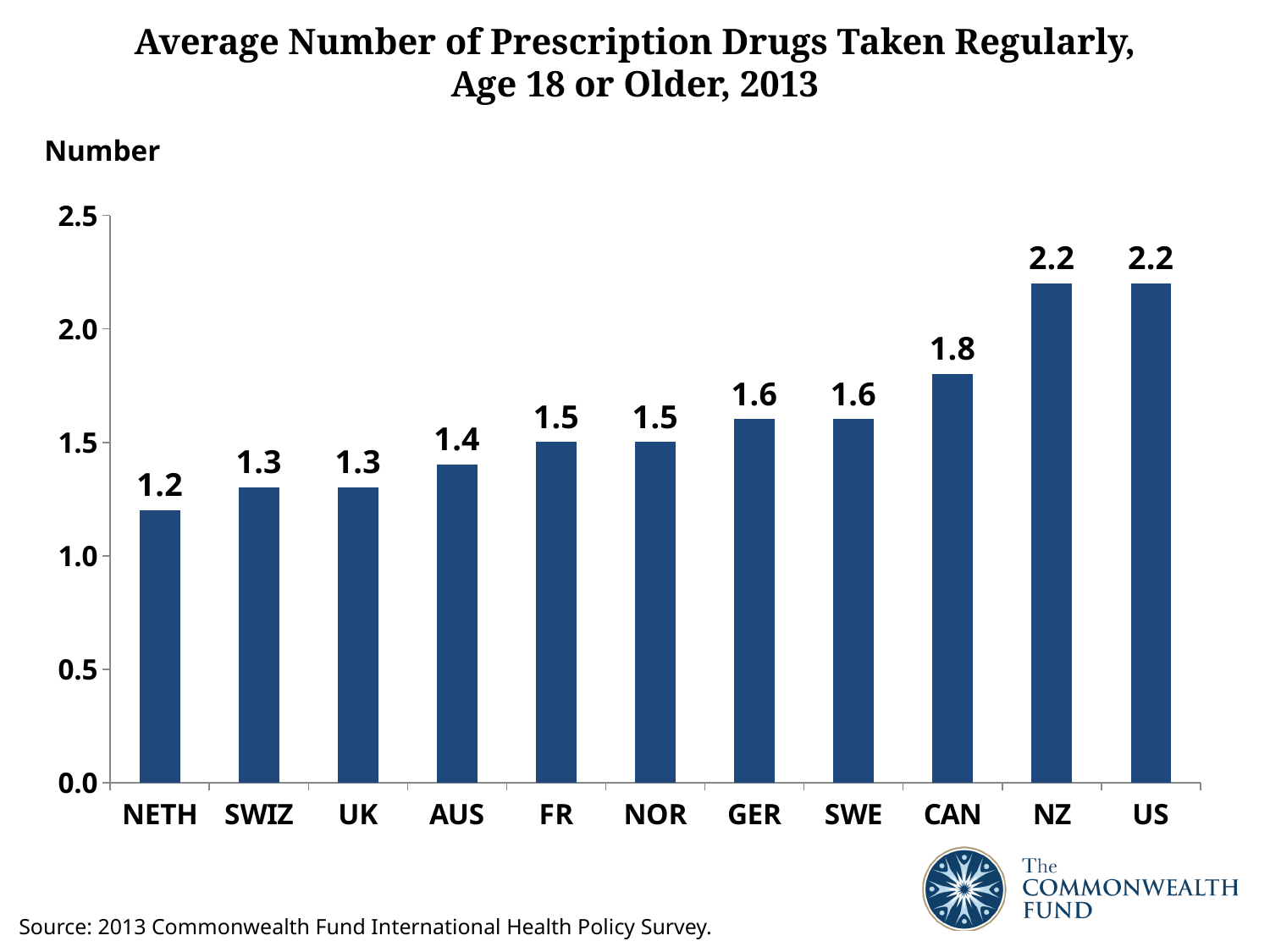
Which is larger, the value for CAN or the value for SWE? CAN What is the value shown for AUS? 1.4 How many countries are shown on the chart? 11 Do the values generally rise or fall from left to right across the x axis? Rise What is the value shown for CAN? 1.8 What is the difference between the values for US and NETH? 1.0 What kind of chart is shown on the slide? Bar chart Is the value for NZ greater or less than 2.0? greater What is the difference between the values for CAN and GER? 0.2 Which country has the lowest average number of prescription drugs taken regularly? NETH What is the average number of prescription drugs taken regularly for NETH? 1.2 Which two countries share the highest value on the chart? NZ and US